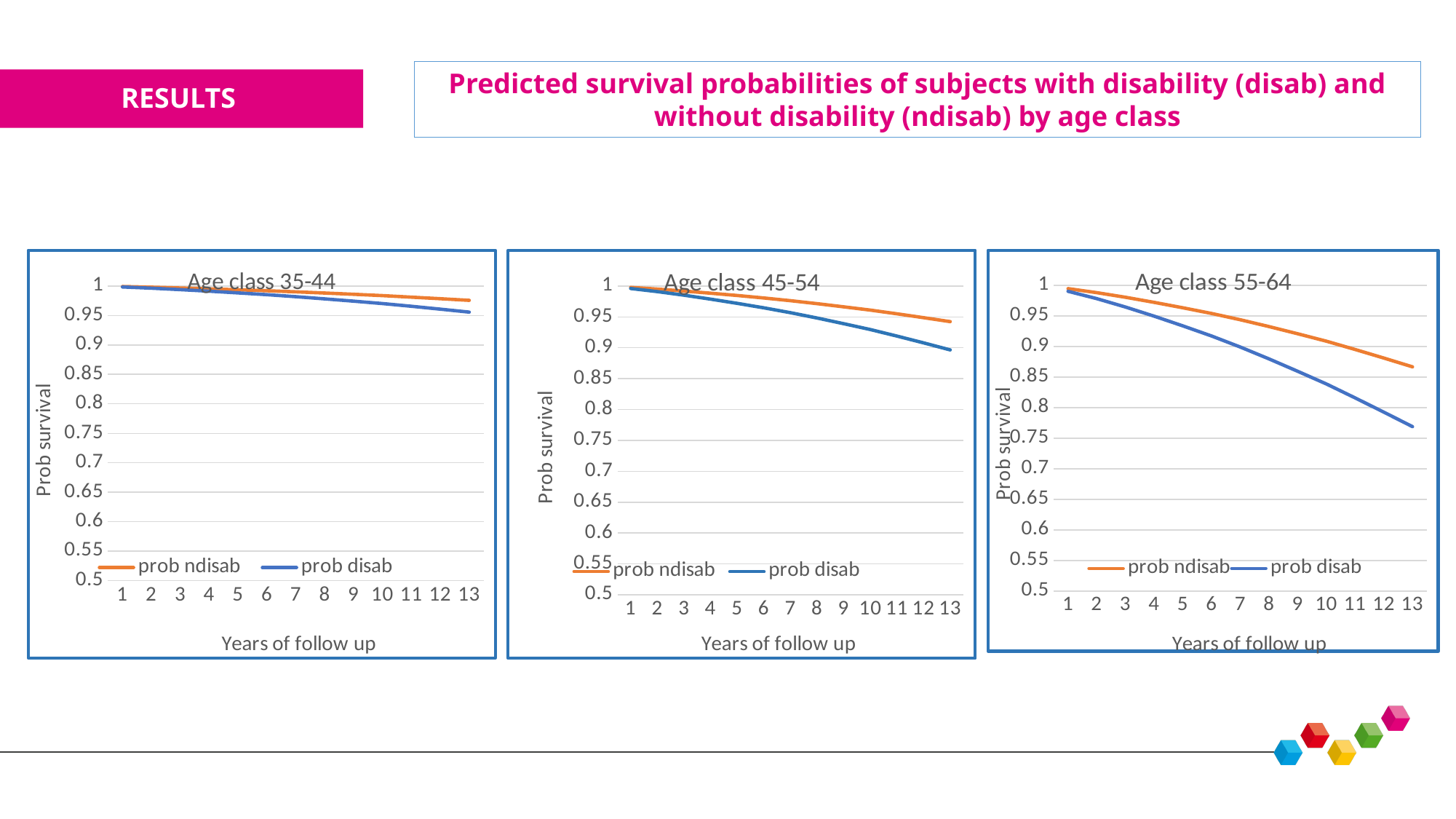
In the 'Age class 45-54' chart, does the 'prob ndisab' line rise or fall along the x axis? fall In the 'Age class 45-54' chart, is the value of 'prob disab' at year 13 greater or less than 0.95? less How many series does the legend of the 'Age class 45-54' chart list? 2 In the 'Age class 35-44' chart, is the value of 'prob disab' at year 13 greater or less than 0.9? greater What colour is the 'prob disab' line in the 'Age class 35-44' chart? blue What is the label of the y axis on the 'Age class 45-54' chart? Prob survival In the 'Age class 55-64' chart, is the value of 'prob ndisab' at year 13 greater or less than 0.85? greater In the 'Age class 55-64' chart, does the 'prob disab' line rise or fall as years of follow up increase? fall In the 'Age class 55-64' chart, which series has the higher value at year 13, 'prob ndisab' or 'prob disab'? prob ndisab How many years of follow up are shown on the x axis of the 'Age class 55-64' chart? 13 What kind of chart is the 'Age class 35-44' chart? line chart